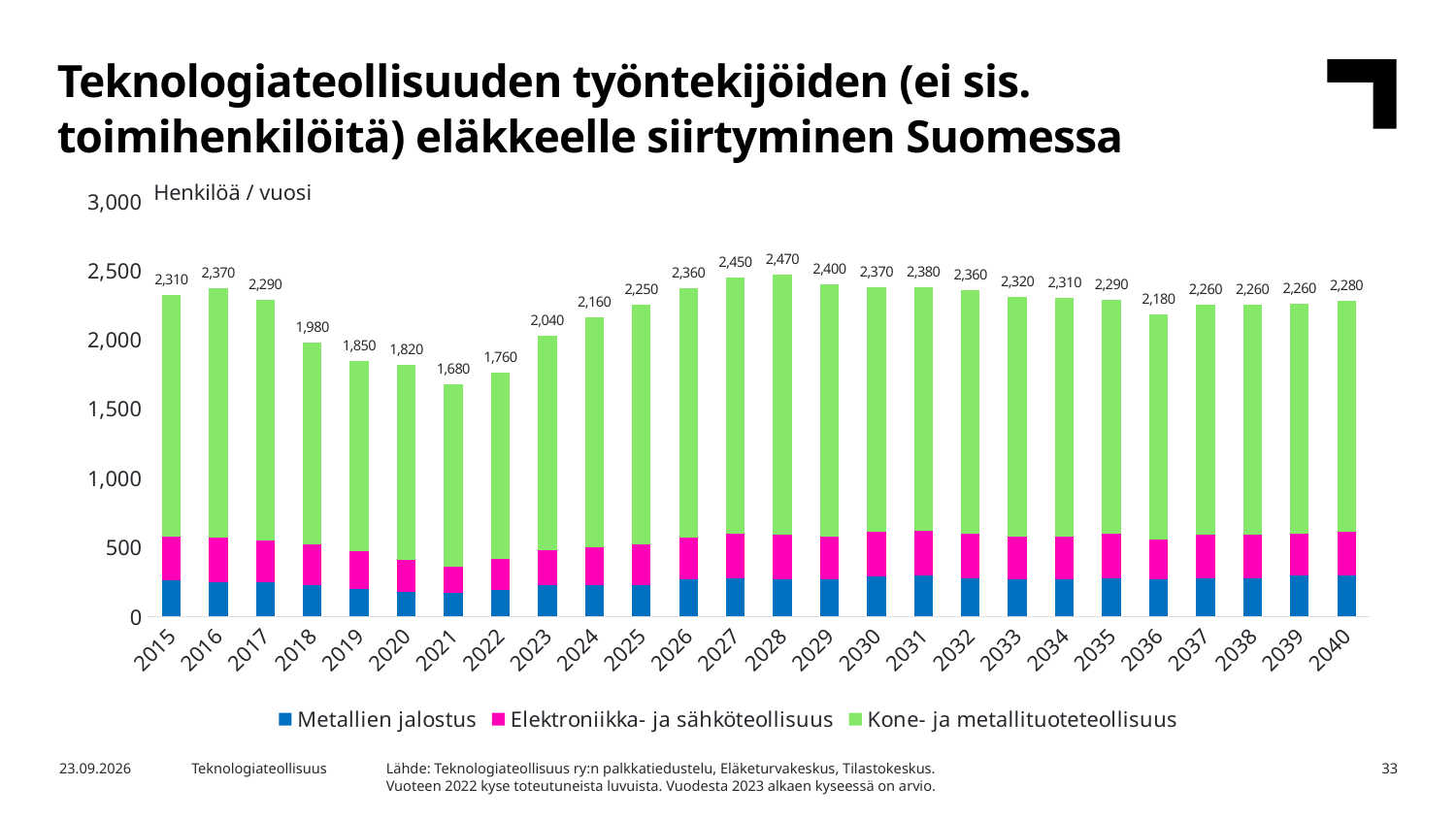
Is the value for Metallien jalostus in 2015 greater or less than 500? less Which year has the lowest total? 2021 What is the total value labelled for 2021? 1,680 What is the label shown above the y axis? Henkilöä / vuosi How many series does the legend list? 3 What kind of chart is shown on the slide? Stacked bar chart What is the difference between the total for 2028 and the total for 2021? 790 Which year has a larger total, 2016 or 2017? 2016 Do the totals rise or fall from 2015 to 2021? Fall Which year has the highest total? 2028 What is the total value labelled for 2028? 2,470 How many years are shown on the x axis? 26